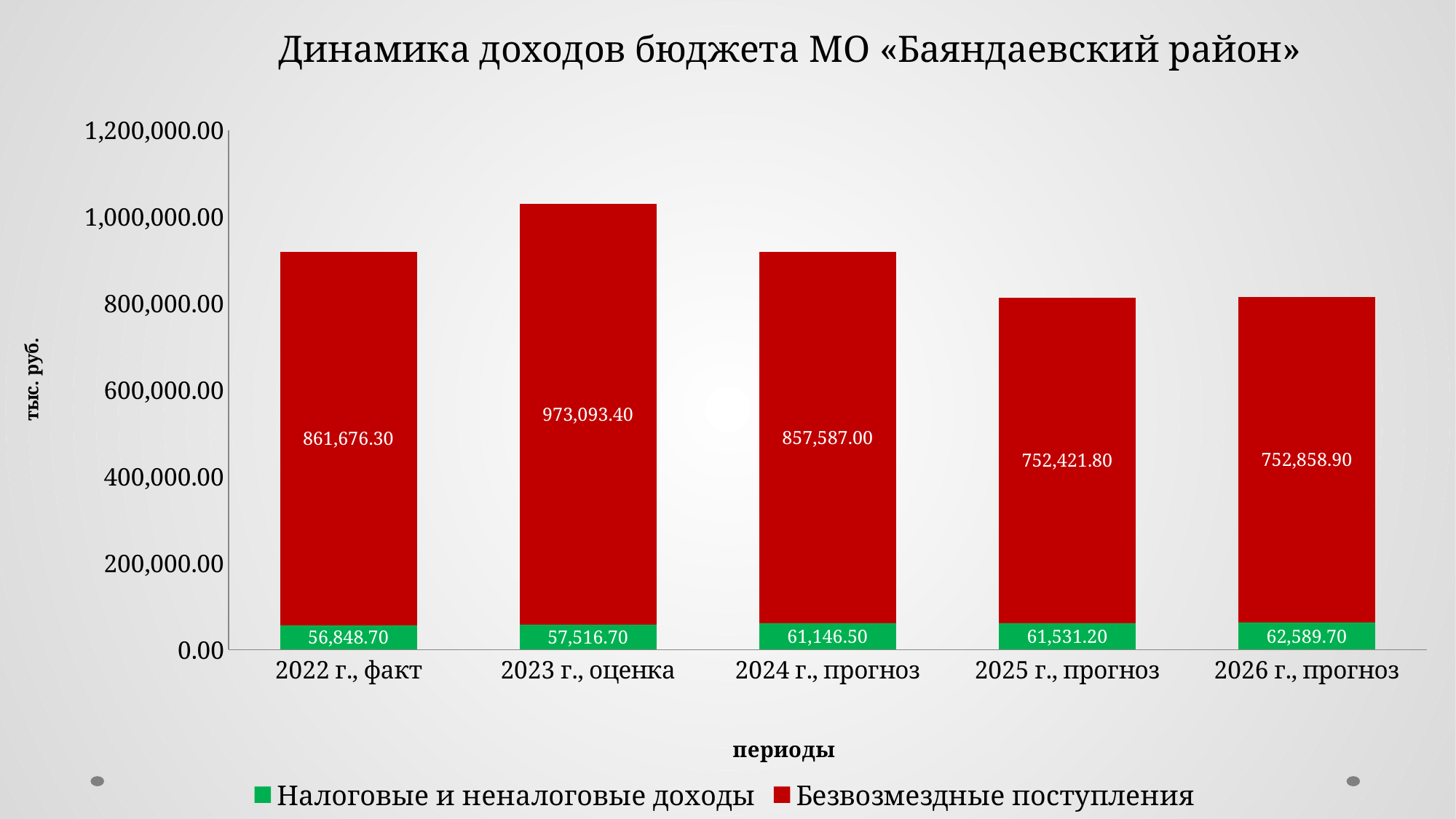
What is the total of the stacked bar for «2025 г., прогноз»? 813,953.00 Is the total height of the stacked bar for «2023 г., оценка» greater or less than 1,000,000.00? greater Which is larger: «Безвозмездные поступления» for «2024 г., прогноз» or for «2025 г., прогноз»? 2024 г., прогноз What is the difference between «Безвозмездные поступления» for «2023 г., оценка» and for «2022 г., факт»? 111,417.10 Do the values of «Налоговые и неналоговые доходы» rise or fall from 2022 to 2026? rise What is the value of «Безвозмездные поступления» for «2023 г., оценка»? 973,093.40 Which period has the lowest value of «Налоговые и неналоговые доходы»? 2022 г., факт What is the value of «Налоговые и неналоговые доходы» for «2025 г., прогноз»? 61,531.20 What kind of chart is shown on the slide? stacked bar chart How many periods are shown on the x axis? 5 Which period has the highest value of «Безвозмездные поступления»? 2023 г., оценка How many series does the legend list? 2